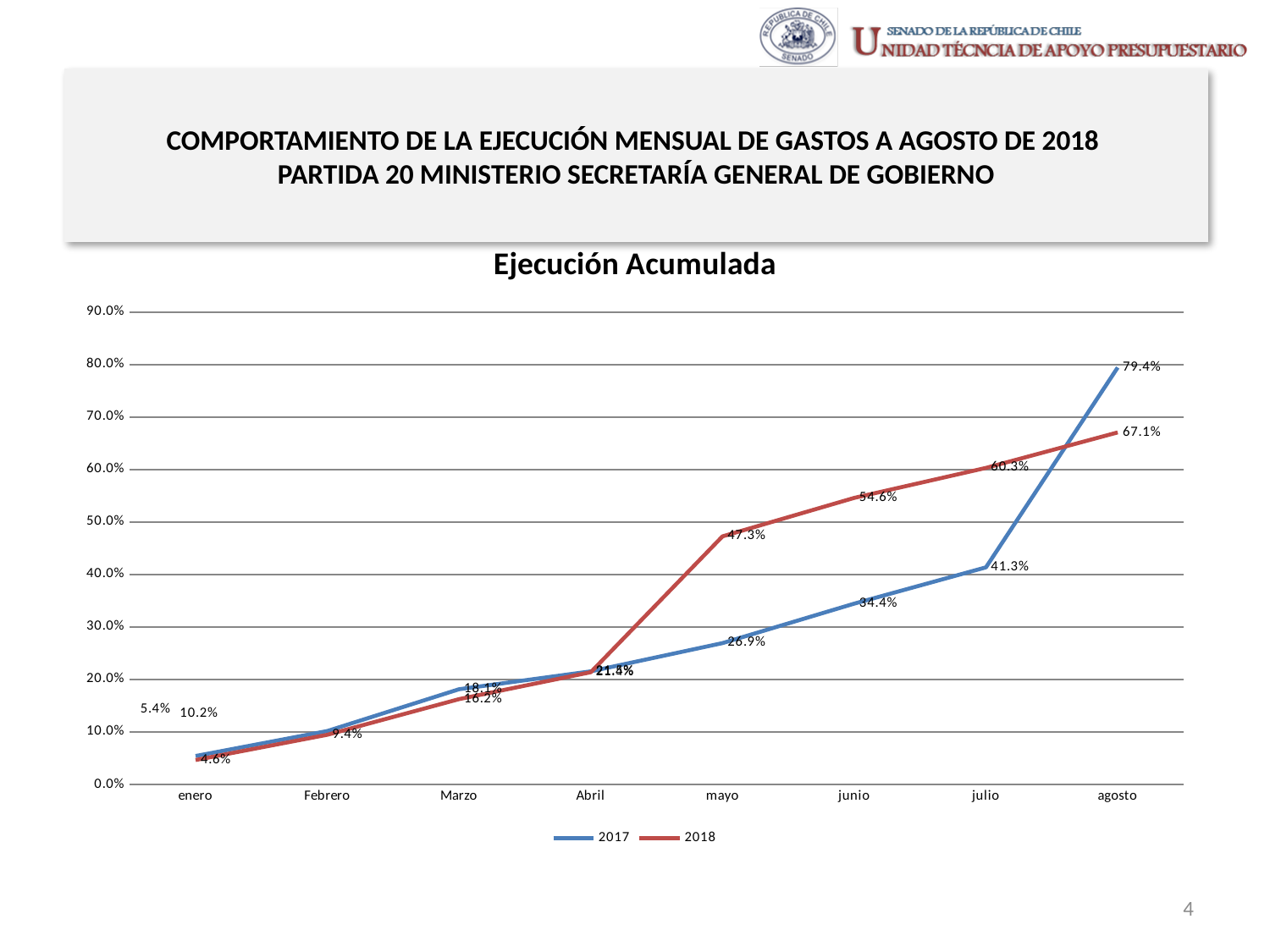
How many series does the legend list? 2 How many months are shown along the x axis? 8 What is the value for 2018 in agosto? 67.1% What is the value for 2017 in agosto? 79.4% Do the values for the 2017 series rise or fall from enero to agosto? Rise What is the value for 2018 in mayo? 47.3% What is the value for 2018 in junio? 54.6% What is the title of the chart? Ejecución Acumulada What is the difference between the 2017 and 2018 values in agosto? 12.3 percentage points In mayo, which series has the higher value, 2017 or 2018? 2018 What is the value for 2017 in julio? 41.3% What kind of chart is shown on the slide? Line chart